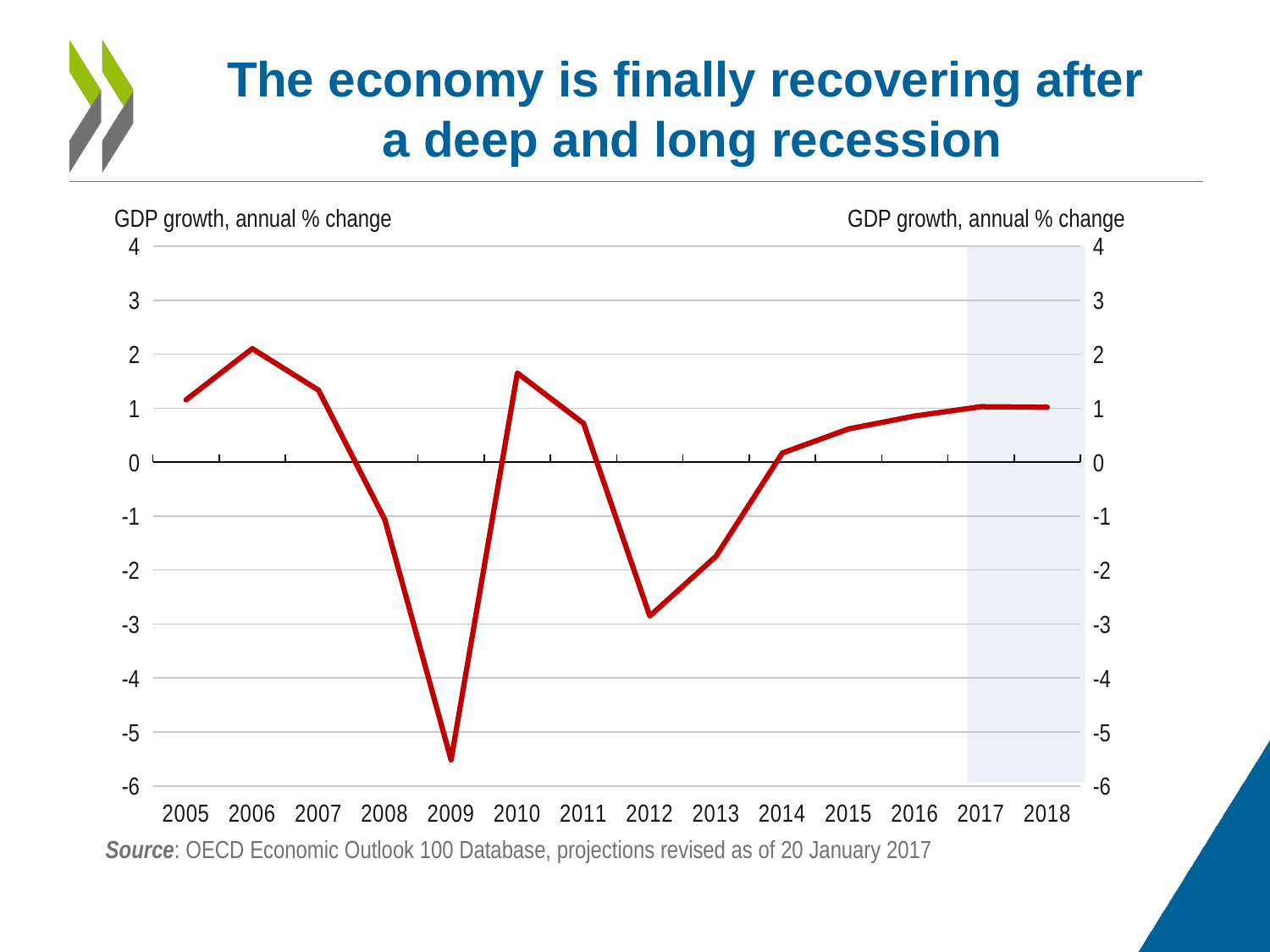
Is the value for 2008 greater or less than 0? less Do the values rise or fall from 2014 to 2017? rise Which year has higher GDP growth, 2013 or 2012? 2013 Is the value for 2009 greater or less than -5? less In which year is GDP growth highest? 2006 What is the label shown above the y axis of the chart? GDP growth, annual % change Which year has higher GDP growth, 2010 or 2011? 2010 How many years are shown on the x axis of the chart? 14 What kind of chart is shown on the slide? line chart Is the value for 2012 greater or less than -2? less In which year is GDP growth lowest? 2009